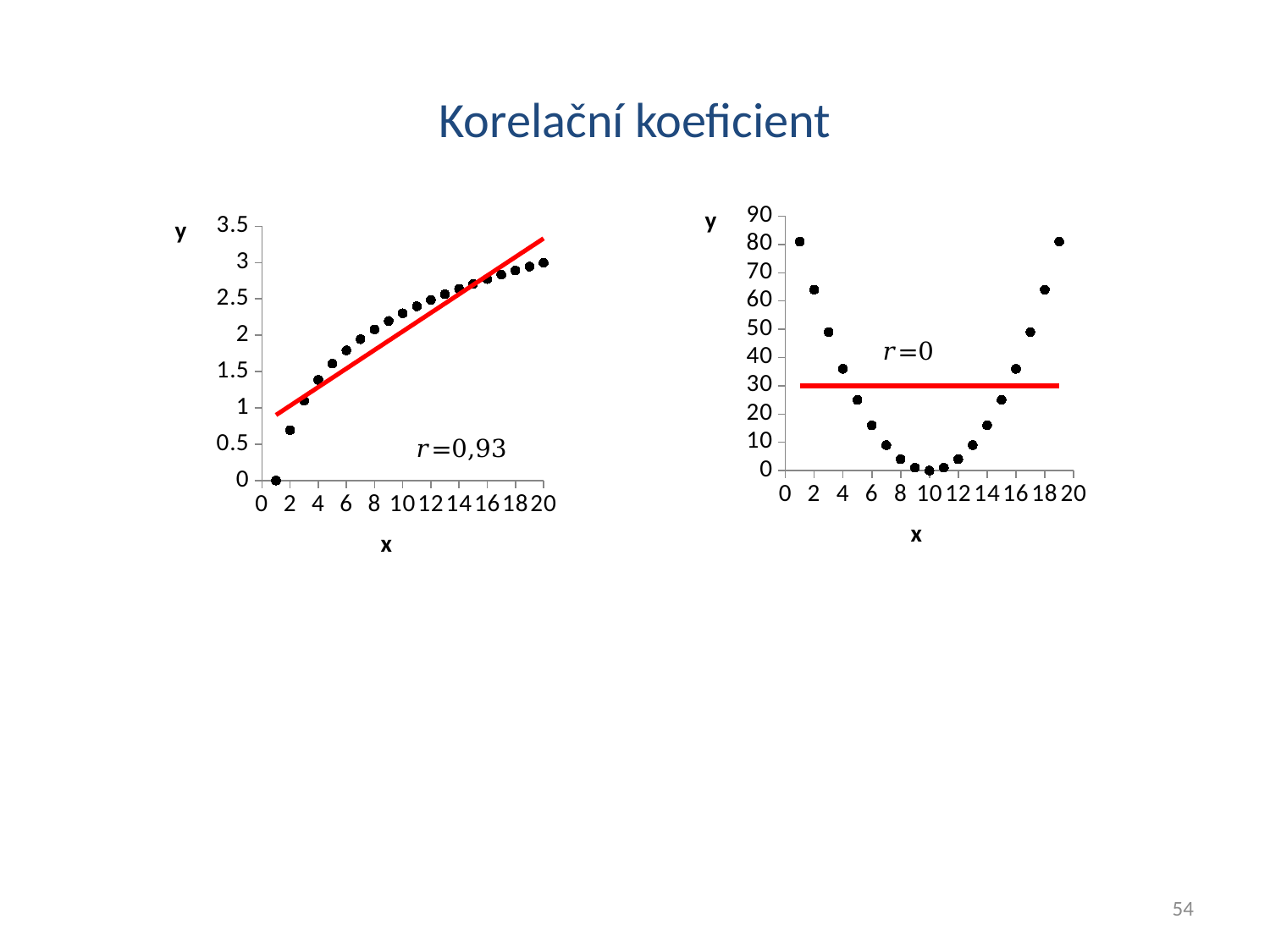
What kind of chart is the left chart on the slide? scatter chart What correlation coefficient is printed on the right chart? r=0 In the left chart, is the value for x = 2 greater or less than 1? less In the right chart, is the value for x = 10 greater or less than 10? less In the left chart, which has the larger y value, x = 2 or x = 20? x = 20 What correlation coefficient is printed on the left chart? r=0,93 In the right chart, is the value for x = 1 greater or less than 70? greater In the left chart, at which x value is the y value highest? 20 In the right chart, which has the larger y value, x = 1 or x = 10? x = 1 In the left chart, do the y values rise or fall as x increases? rise In the right chart, how do the y values change as x increases from 0 to 20? fall then rise